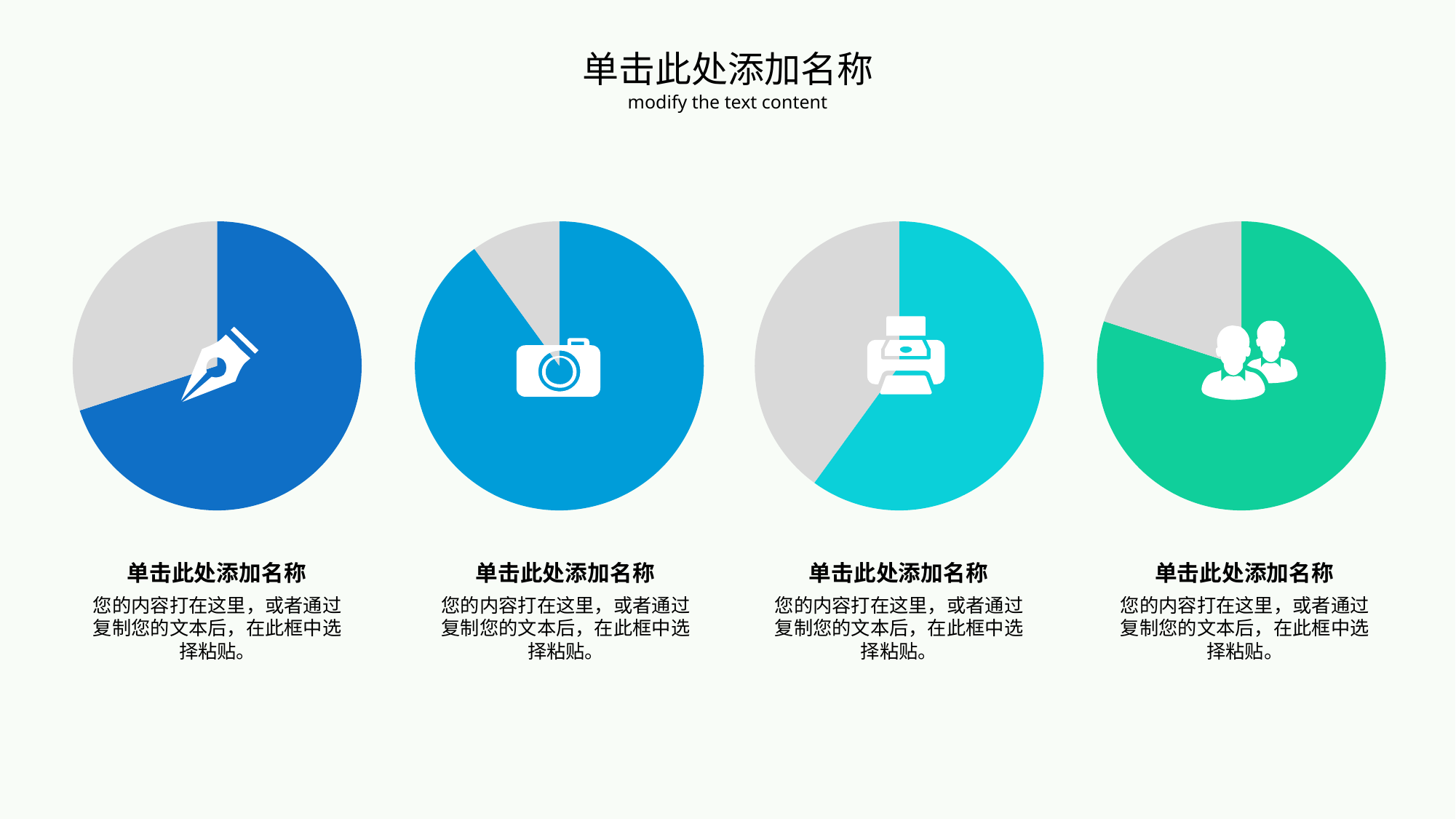
What is the English subtitle shown under the slide title? modify the text content In the leftmost pie chart (with the pen icon), which slice is larger, the blue slice or the grey slice? the blue slice How many slices does the leftmost pie chart (with the pen icon) have? 2 Which of the four pie charts has the largest grey slice? the third from the left (printer icon) In the third pie chart from the left (with the printer icon), which slice is larger, the cyan slice or the grey slice? the cyan slice How many pie charts are shown on the slide? 4 How many slices does the rightmost pie chart (with the people icon) have? 2 In the second pie chart from the left (with the camera icon), which slice is larger, the blue slice or the grey slice? the blue slice Which of the four pie charts has the smallest grey slice? the second from the left (camera icon) What colour is the larger slice of the rightmost pie chart? green What kind of chart is the leftmost chart on the slide? pie chart